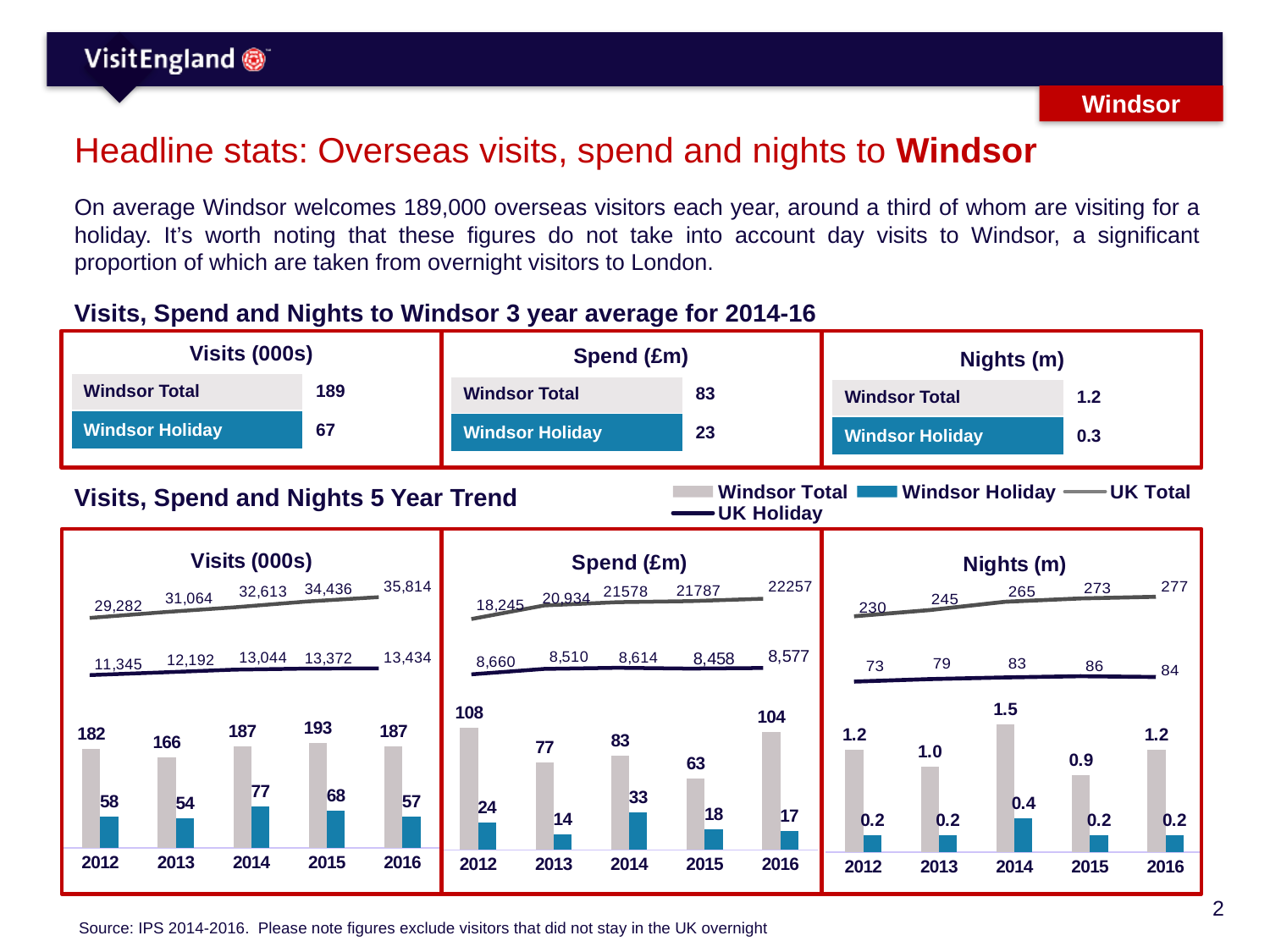
In the Nights (m) trend chart, what is the Windsor Total value for 2014? 1.5 In the Visits (000s) trend chart, does the UK Total line rise or fall from 2012 to 2016? Rise How many years are shown on the x axis of the Spend (£m) trend chart? 5 How many series does the legend for the 5 Year Trend charts list? 4 In the Spend (£m) trend chart, what is the Windsor Total value for 2012? 108 In the Spend (£m) trend chart, which year has the lowest Windsor Total value? 2015 In the Nights (m) trend chart, what is the UK Total value for 2016? 277 In the Spend (£m) trend chart, which year has the larger Windsor Holiday value, 2012 or 2014? 2014 What kind of chart is the Visits (000s) 5 Year Trend chart? A bar chart with line series In the Visits (000s) trend chart, which year has the highest Windsor Holiday value? 2014 In the Visits (000s) trend chart, what is the Windsor Total value for 2015? 193 In the Spend (£m) trend chart, what is the difference between Windsor Total and Windsor Holiday in 2016? 87